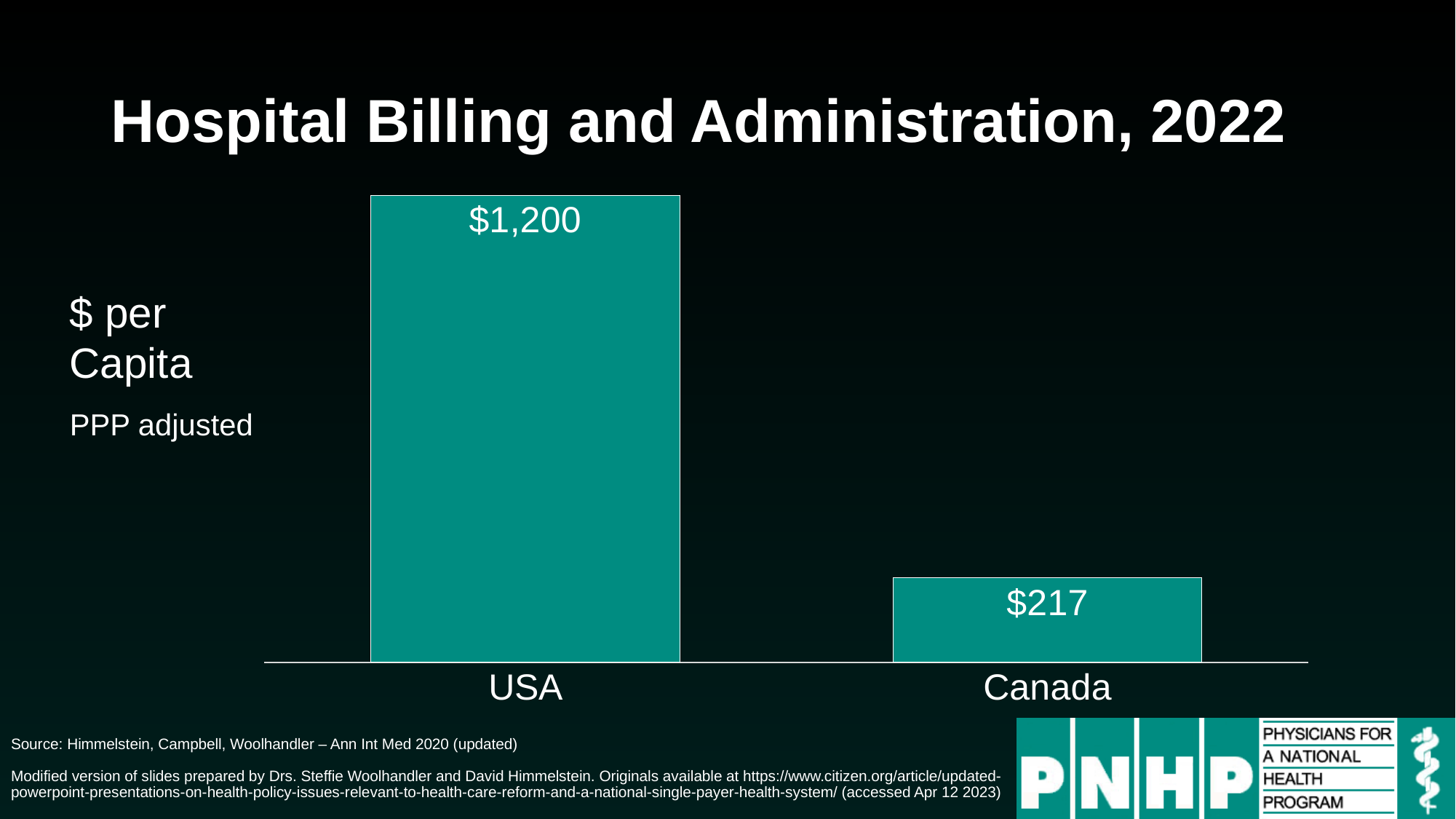
Which country has the higher hospital billing and administration cost per capita? USA Which country has the lower hospital billing and administration cost per capita? Canada What is the hospital billing and administration cost per capita for the USA? $1,200 What kind of chart is shown on the slide? bar chart What unit is the chart's vertical axis labelled with? $ per Capita, PPP adjusted How many countries are shown in the chart? 2 What is the title of the chart on the slide? Hospital Billing and Administration, 2022 Is the value for the USA larger or smaller than the value for Canada? larger What is the hospital billing and administration cost per capita for Canada? $217 What is the difference between the USA and Canada values for hospital billing and administration per capita? $983